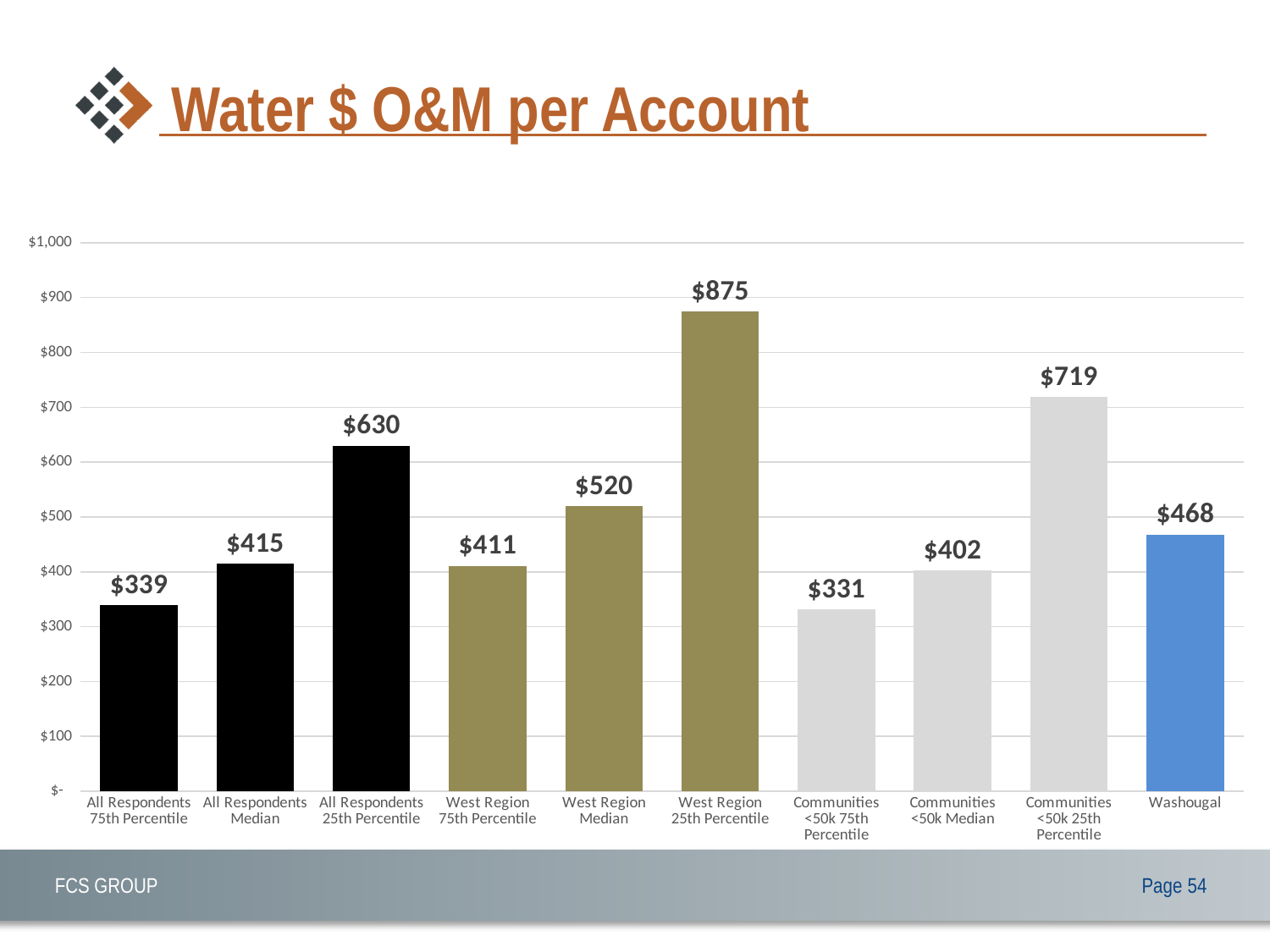
What is the value for West Region Median? $520 Is the value for Communities <50k 25th Percentile greater or less than $700? greater What is the value for Communities <50k 75th Percentile? $331 How many bars are shown in the chart? 10 Which category has the highest value? West Region 25th Percentile What is the difference between the West Region 25th Percentile and the All Respondents 25th Percentile values? $245 Which is larger, the value for Washougal or the value for All Respondents Median? Washougal Which category has the lowest value? Communities <50k 75th Percentile What is the value for Washougal? $468 What is the title of the slide? Water $ O&M per Account What kind of chart is shown on the slide? Bar chart What colour is the Washougal bar? Blue